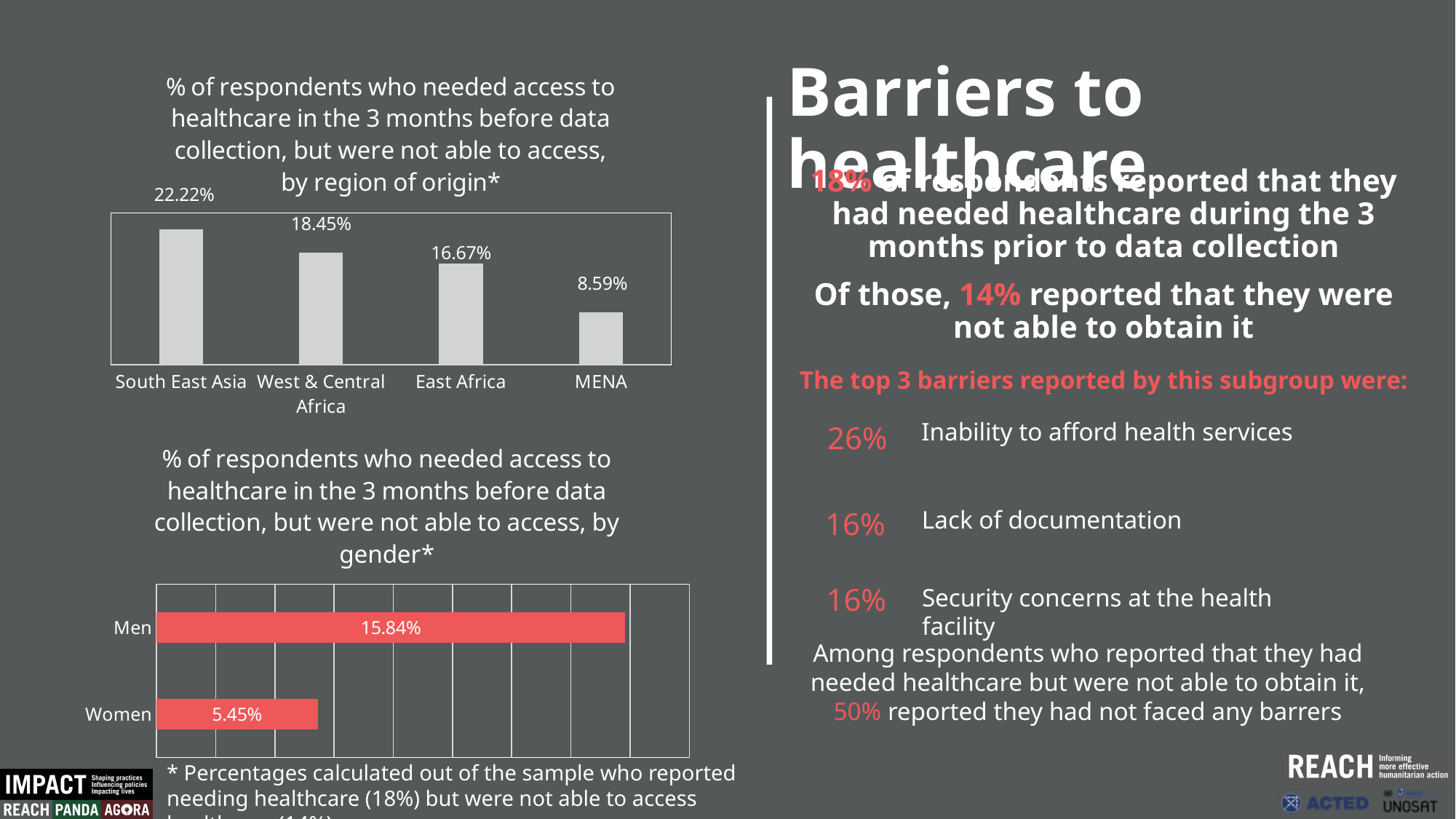
In the chart by gender, what is the difference between the values for Men and Women? 10.39% In the chart by region of origin, what is the value for South East Asia? 22.22% In the chart by region of origin, what is the value for MENA? 8.59% In the chart by gender, what is the value for Women? 5.45% In the chart by region of origin, do the values rise or fall from left to right? fall In the chart by region of origin, which region has the highest value? South East Asia In the chart by region of origin, what is the difference between West & Central Africa and East Africa? 1.78% In the chart by gender, which is larger, the value for Men or for Women? Men In the chart by gender, what is the value for Men? 15.84% In the chart by region of origin, how many regions are shown? 4 In the chart by region of origin, which region has the lowest value? MENA What type of chart is the chart by gender? bar chart